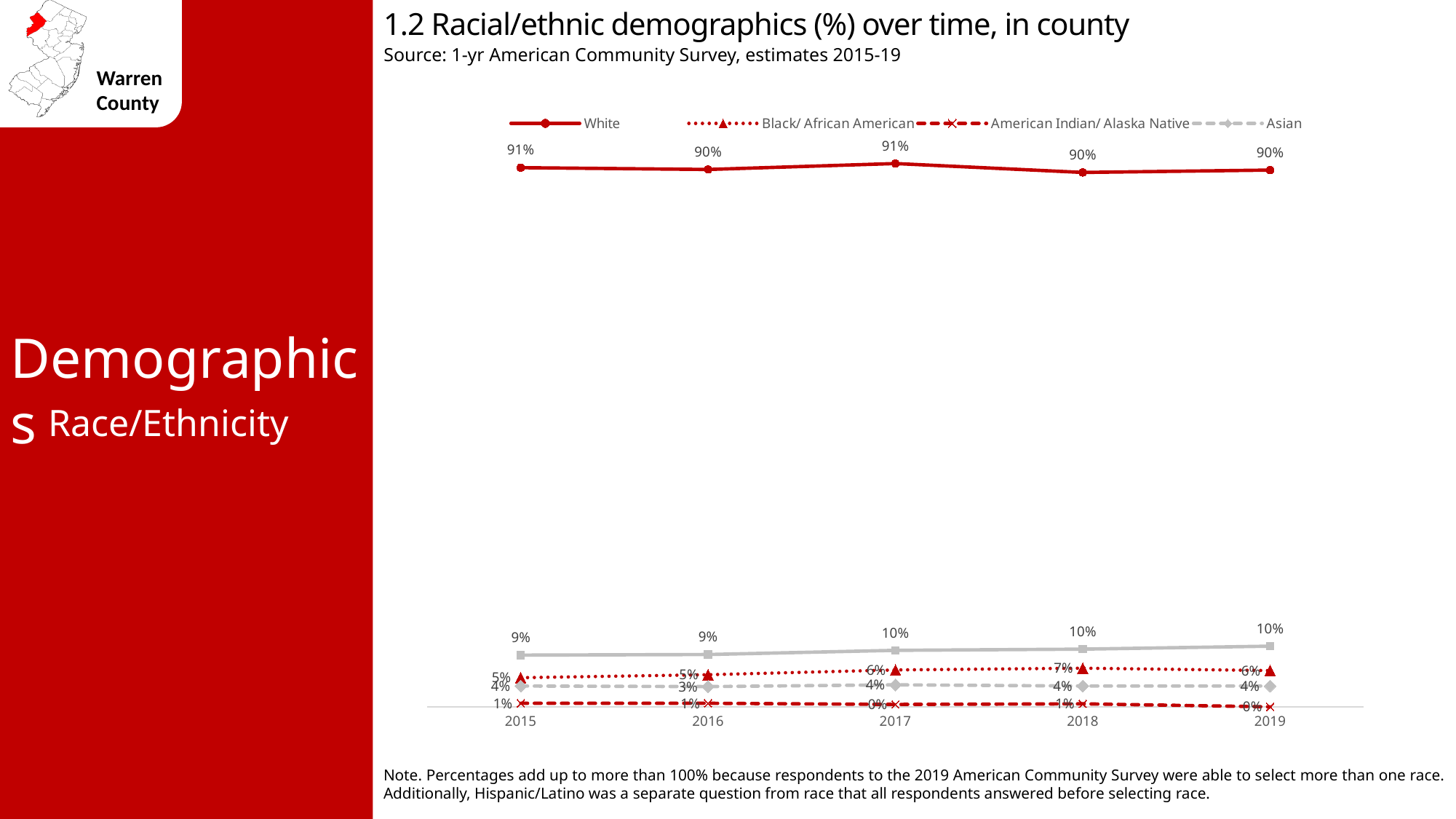
What is the difference between the White share and the Black/African American share in 2019? 84% How many series are listed in the legend? 4 What is the source cited for the chart? 1-yr American Community Survey, estimates 2015-19 What was the White share of the county population in 2015? 91% Which was larger in 2017, the Black/African American share or the Asian share? Black/African American Did the Black/African American share rise or fall from 2015 to 2018? rise In which year was the Black/African American share highest? 2018 How many years are shown on the x axis? 5 What was the Asian share in 2016? 3% What was the American Indian/Alaska Native share in 2017? 0% What was the Black/African American share in 2018? 7% What kind of chart is shown on the slide? line chart